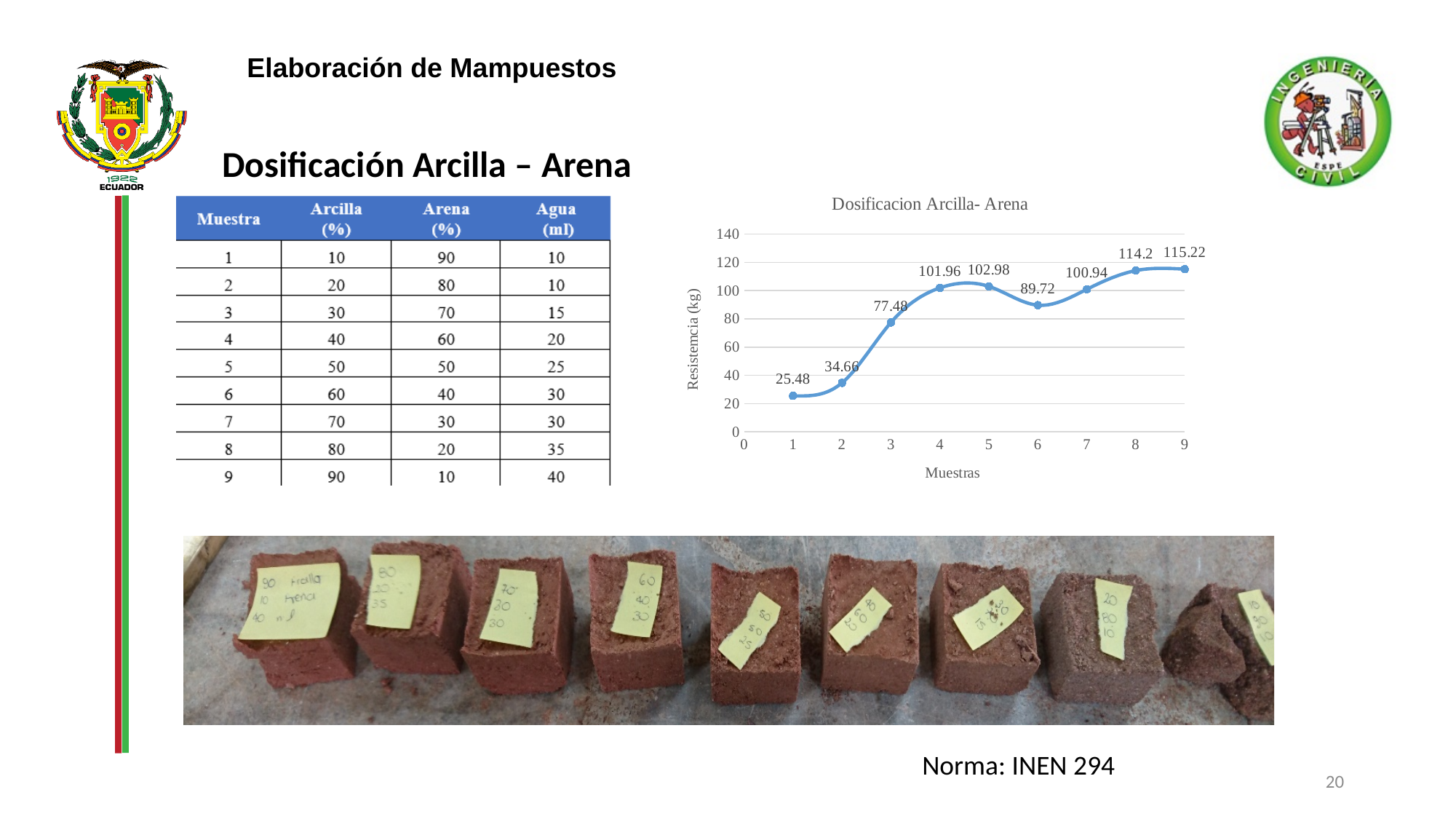
Does the Resistemcia (kg) rise or fall from Muestra 5 to Muestra 6? fall Which Muestra has the highest Resistemcia (kg)? 9 What is the Resistemcia (kg) value for Muestra 3? 77.48 What is the label of the x axis of the chart? Muestras What type of chart is shown on the slide? line chart What is the Resistemcia (kg) value for Muestra 6? 89.72 Which has a higher Resistemcia (kg), Muestra 3 or Muestra 6? Muestra 6 Which Muestra has the lowest Resistemcia (kg)? 1 How many data points are plotted on the chart? 9 What is the title of the chart? Dosificacion Arcilla- Arena What is the Resistemcia (kg) value for Muestra 1? 25.48 What is the difference in Resistemcia (kg) between Muestra 9 and Muestra 1? 89.74